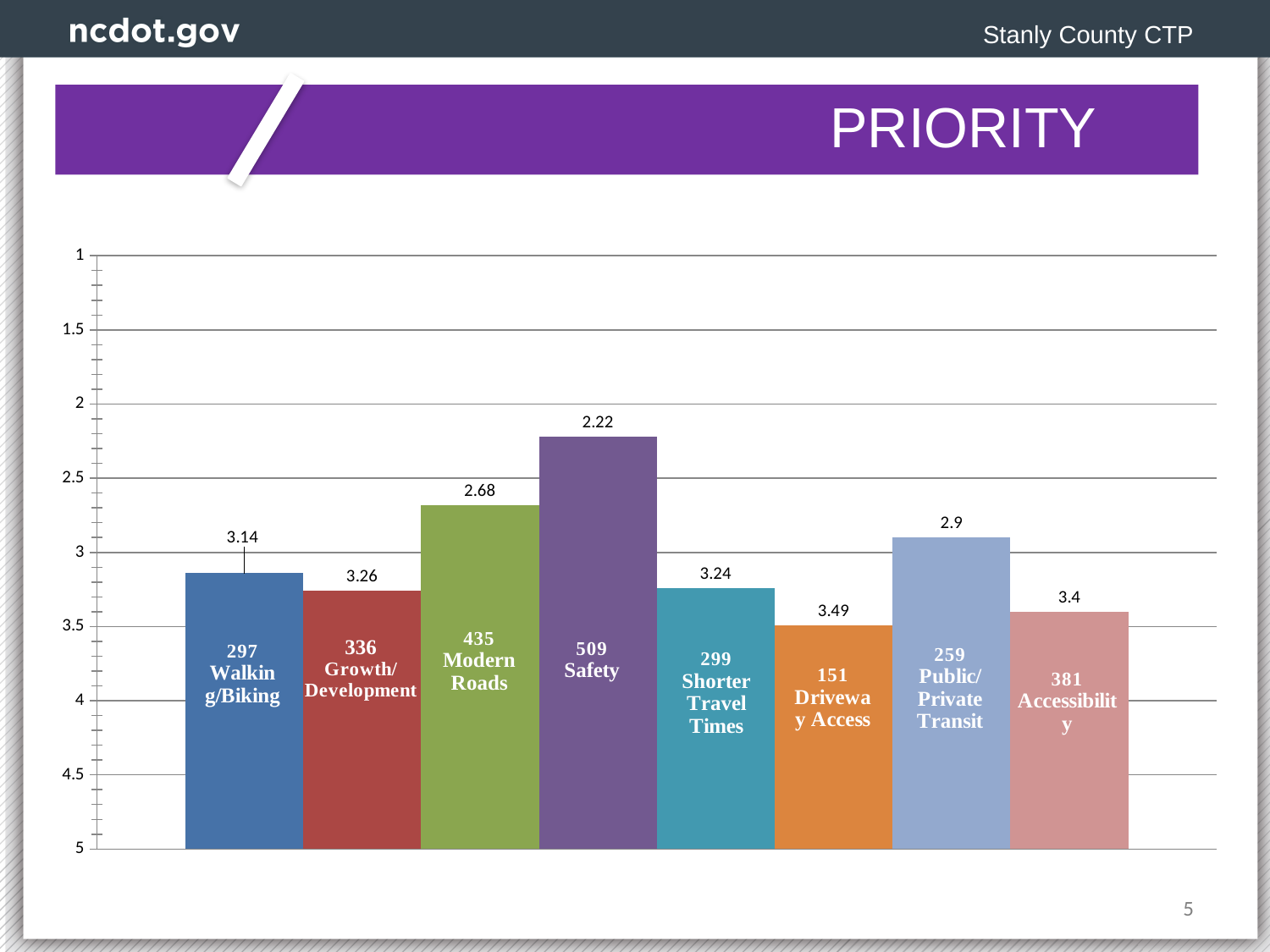
What kind of chart is shown on the slide? Bar chart What number is printed inside the Safety bar above its label? 509 What is the value shown for Driveway Access? 3.49 Which category has the smallest numeric value? Safety Which category has the largest numeric value? Driveway Access What is the difference between the values for Driveway Access and Safety? 1.27 What is the value shown for Public/Private Transit? 2.9 What is the value shown for Safety? 2.22 What is the value shown for Modern Roads? 2.68 Which has the larger numeric value, Walking/Biking or Growth/Development? Growth/Development What is the difference between the values for Accessibility and Public/Private Transit? 0.5 How many categories are plotted in the chart? 8